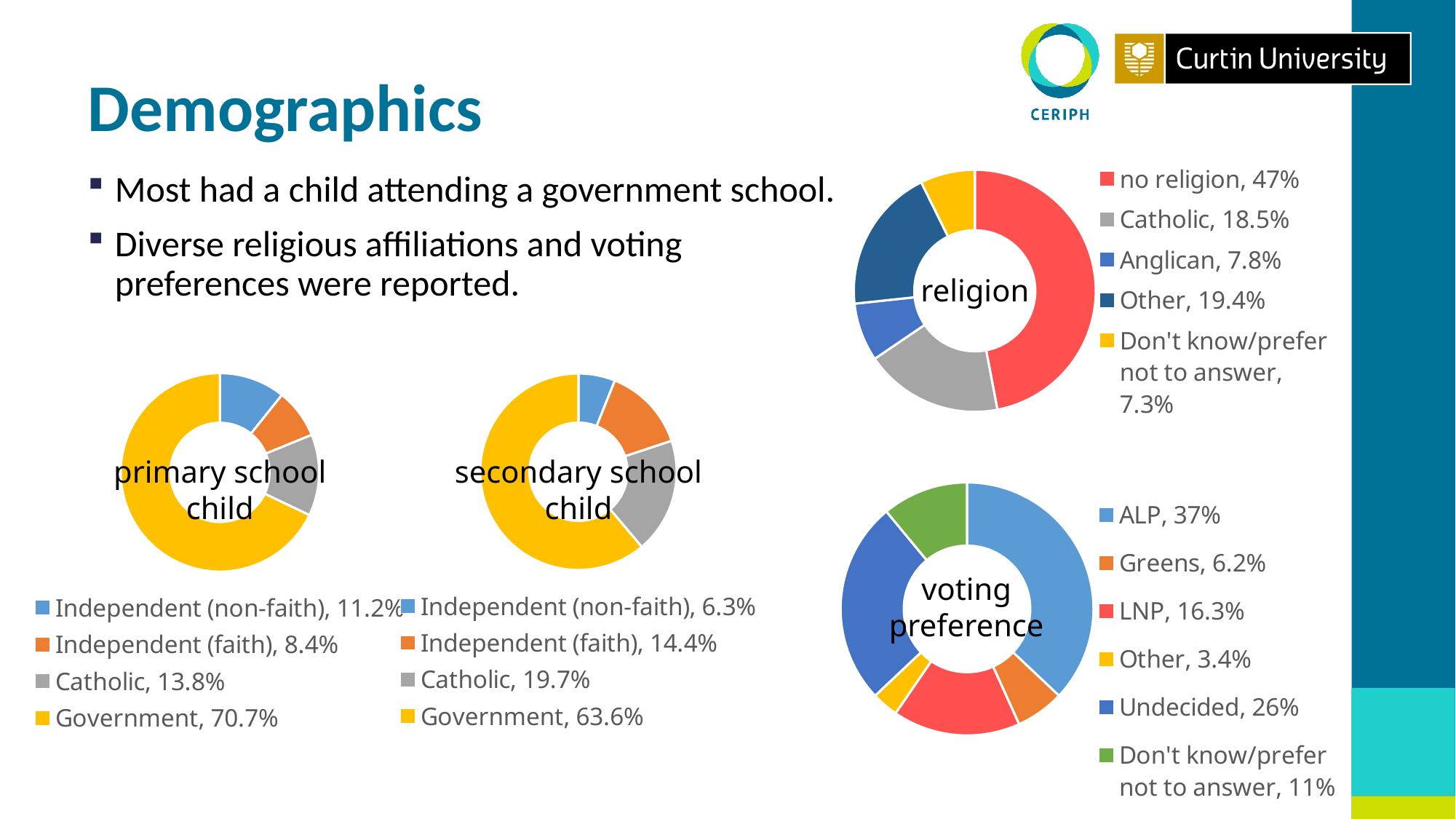
In the 'secondary school child' chart, which category has the smallest share? Independent (non-faith) How many categories does the 'religion' chart show? 5 In the 'primary school child' chart, what share is Government? 70.7% How many categories does the 'voting preference' chart show? 6 In the 'voting preference' chart, what share is Undecided? 26% In the 'religion' chart, which category has the largest share? no religion What kind of chart is the 'primary school child' chart? Doughnut chart In the 'religion' chart, what share is Anglican? 7.8% In the 'secondary school child' chart, what share is Catholic? 19.7% Which is larger: Independent (faith) in the 'primary school child' chart or Independent (faith) in the 'secondary school child' chart? secondary school child In the 'voting preference' chart, what is the difference between ALP and LNP? 20.7% In the 'voting preference' chart, which category has the smallest share? Other